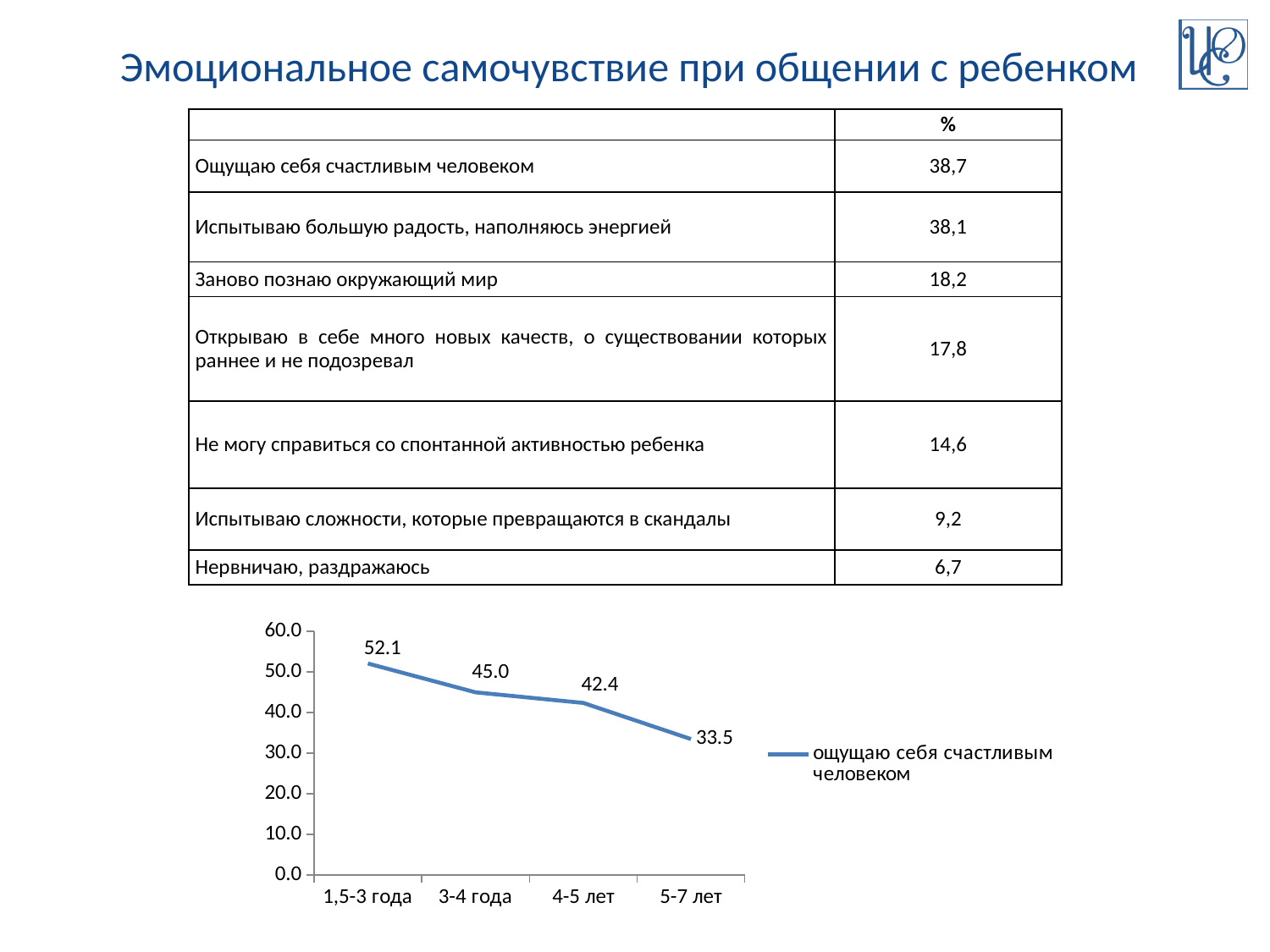
What type of chart is shown on the slide? line chart What is the value for the 1,5-3 года category in the line chart? 52.1 What series name does the legend of the line chart show? ощущаю себя счастливым человеком What is the value for the 3-4 года category in the line chart? 45.0 Which is larger in the line chart, the value for 3-4 года or the value for 4-5 лет? 3-4 года Which age category has the highest value in the line chart? 1,5-3 года What is the difference between the values for 1,5-3 года and 5-7 лет in the line chart? 18.6 How many age categories are plotted on the x axis of the line chart? 4 What is the value for the 4-5 лет category in the line chart? 42.4 Which age category has the lowest value in the line chart? 5-7 лет What is the value for the 5-7 лет category in the line chart? 33.5 Do the values in the line chart rise or fall from 1,5-3 года to 5-7 лет? fall